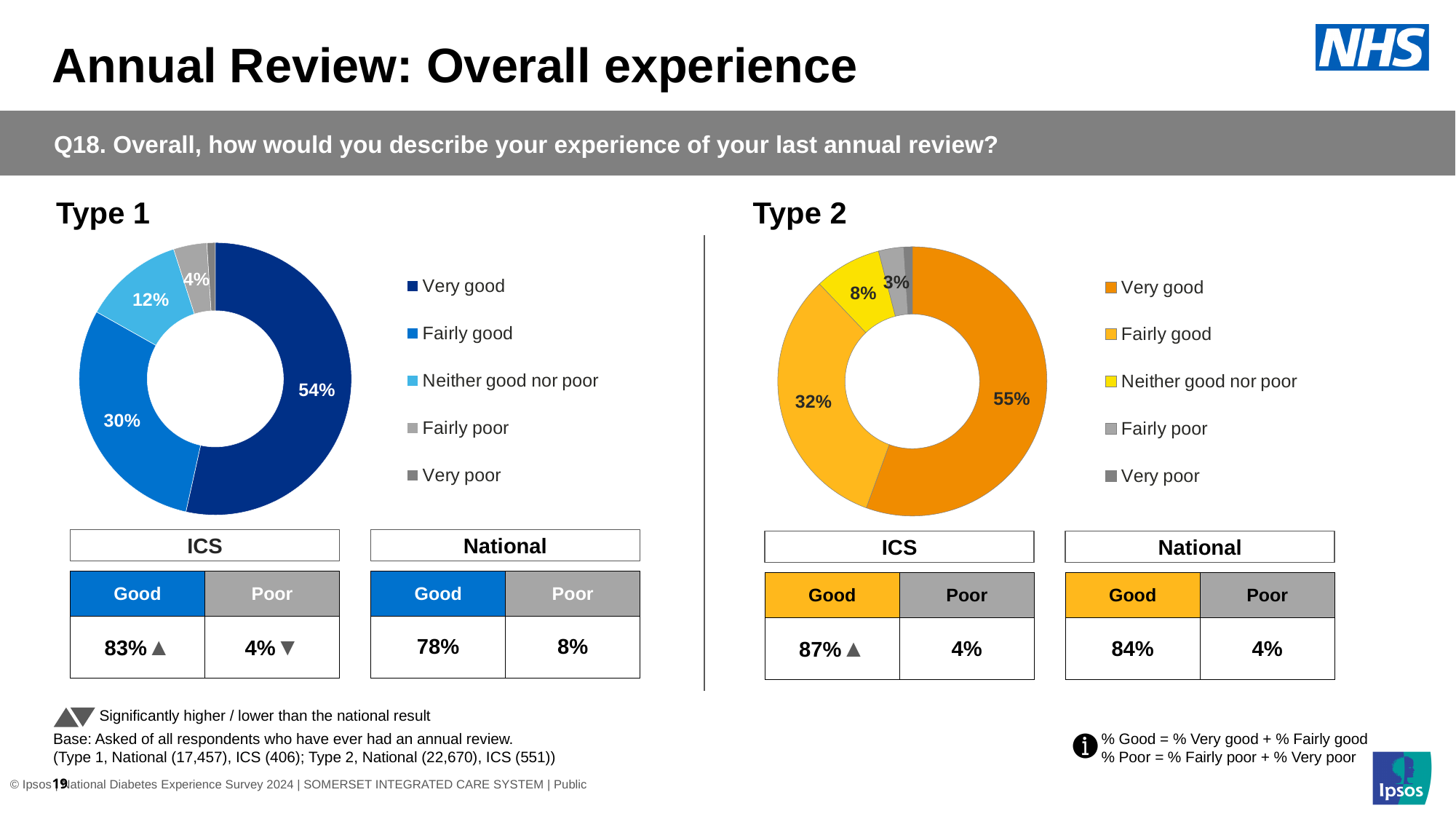
In the Type 1 chart, what percentage of respondents said their experience was Very good? 54% In the Type 1 chart, which response category has the smallest share? Very poor In the Type 1 chart, what percentage of respondents said Fairly good? 30% In the Type 2 chart, what percentage of respondents said Fairly poor? 3% What kind of chart is used to show the Type 2 results? Donut (pie) chart In the Type 1 chart, what is the difference between the Very good and Fairly good shares? 24 percentage points In the Type 2 chart, what percentage of respondents said Neither good nor poor? 8% How many response categories does the legend of the Type 1 chart list? 5 In the Type 2 chart, which response category has the largest share? Very good Which is larger: the Fairly good share in the Type 1 chart or the Fairly good share in the Type 2 chart? Type 2 In the Type 2 chart, what colour represents Neither good nor poor? Yellow